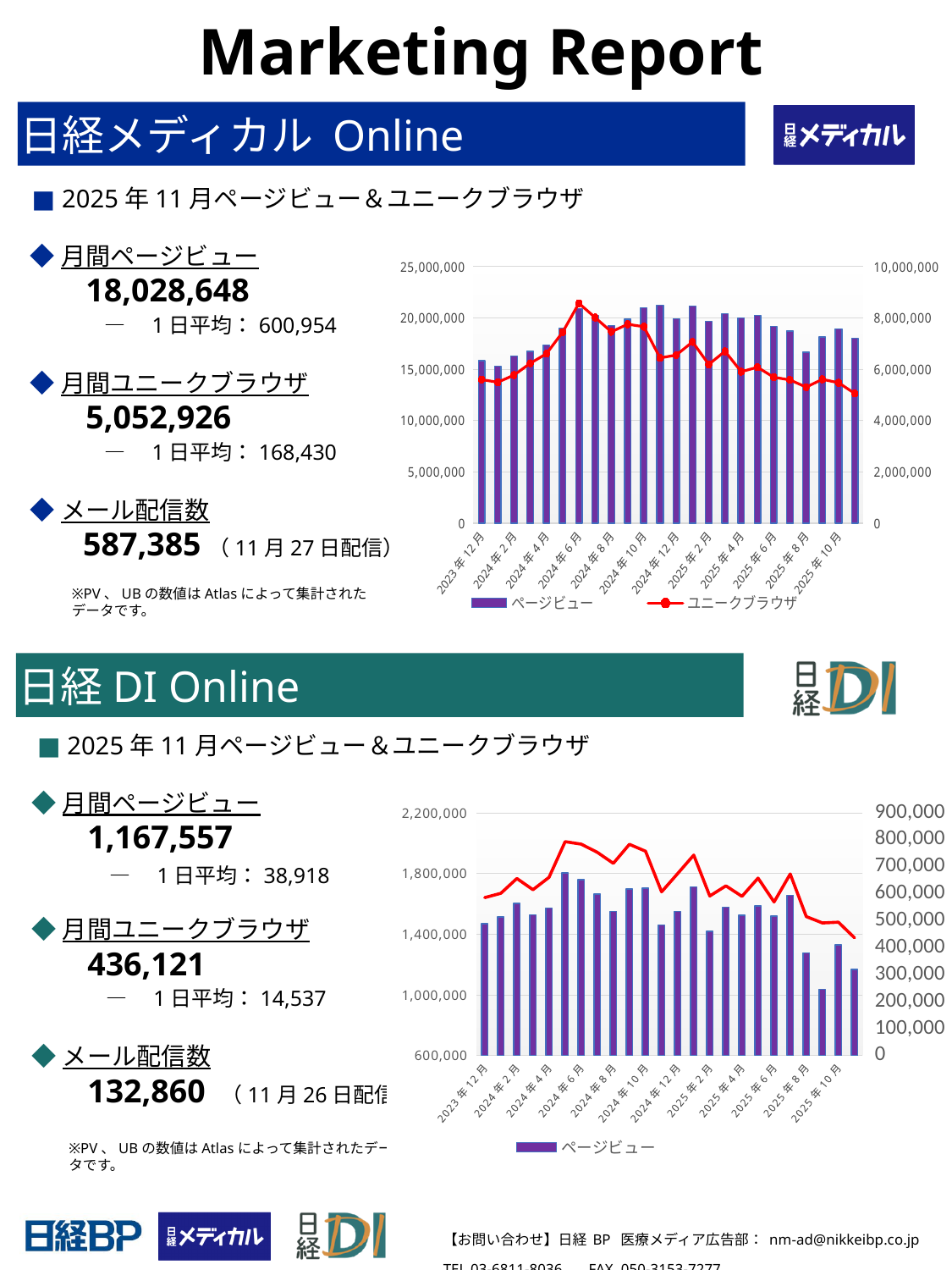
On the 日経メディカル Online chart, does the ユニークブラウザ line rise or fall from 2024年6月 to 2025年10月? fall What kind of chart is the 日経メディカル Online chart? Bar and line chart On the 日経 DI Online chart, is the ページビュー value for 2025年9月 greater or less than 1,400,000? less On the 日経 DI Online chart, how many entries does the legend list? 1 On the 日経メディカル Online chart, which is larger, the ページビュー bar for 2024年6月 or for 2023年12月? 2024年6月 On the 日経 DI Online chart, in which month is the ページビュー bar lowest? 2025年9月 On the 日経メディカル Online chart, how many series does the legend list? 2 On the 日経 DI Online chart, is the red line value for 2024年6月 greater or less than 700,000 on the right axis? greater On the 日経メディカル Online chart, in which month does the ユニークブラウザ line reach its highest point? 2024年6月 On the 日経メディカル Online chart, is the ユニークブラウザ value for 2024年6月 greater or less than 8,000,000? greater On the 日経メディカル Online chart, what are the two legend entries? ページビュー and ユニークブラウザ